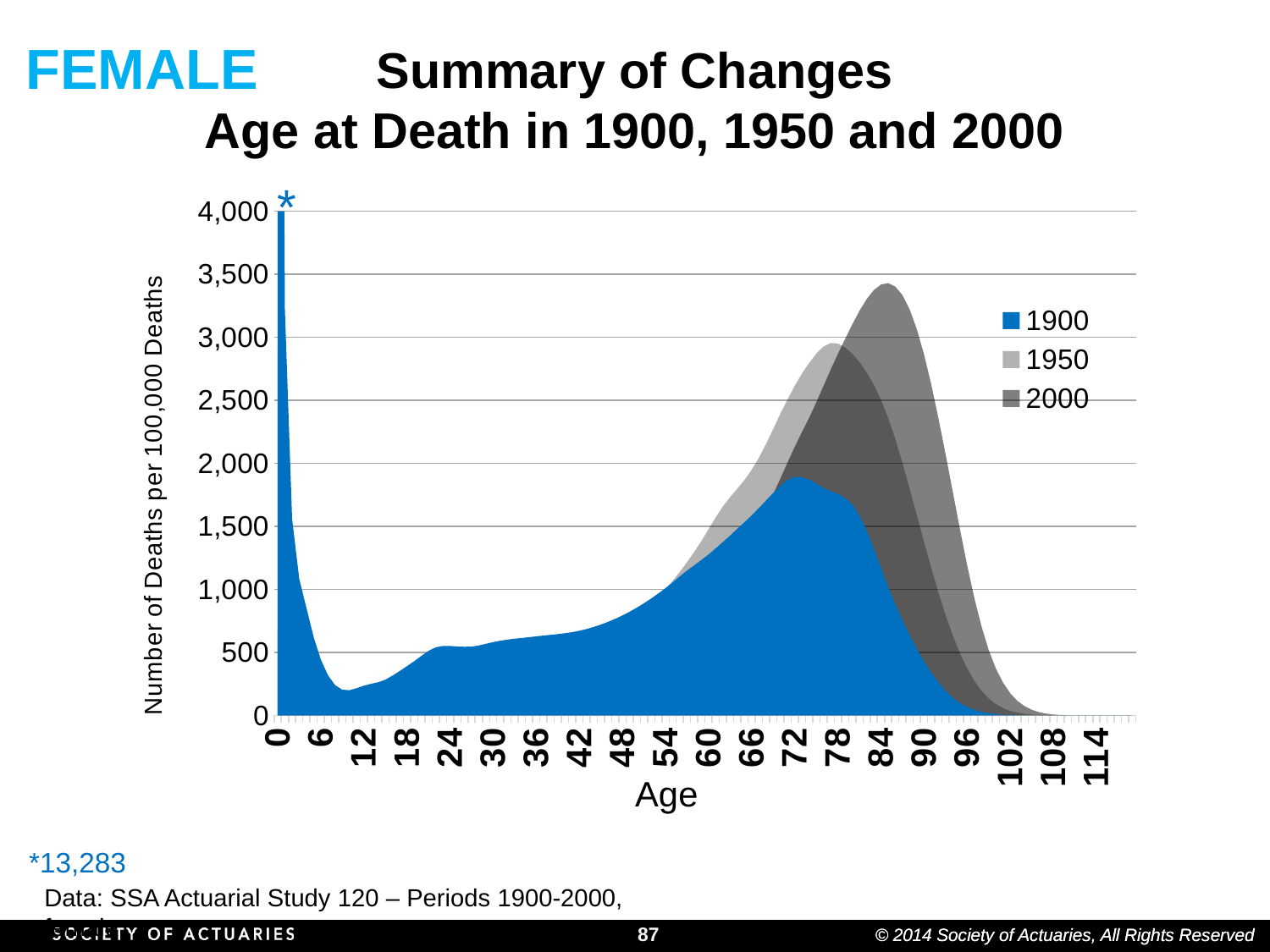
Is the value for the 1900 series at age 6 greater or less than 500? less At age 84, which series has the larger value, 1900 or 2000? 2000 What is the title of the y axis? Number of Deaths per 100,000 Deaths What kind of chart is shown on the slide? area chart What are the three series listed in the legend? 1900, 1950, 2000 How many series does the legend list? 3 Which series reaches the highest peak value? 1900 Does the 1900 series rise or fall between age 0 and age 6? fall Is the peak value of the 2000 series greater or less than 3,000? greater Which series has the lowest peak value? 1950 What value does the asterisk at age 0 refer to, according to the footnote? 13,283 Is the peak value of the 1900 series greater or less than 2,000? greater